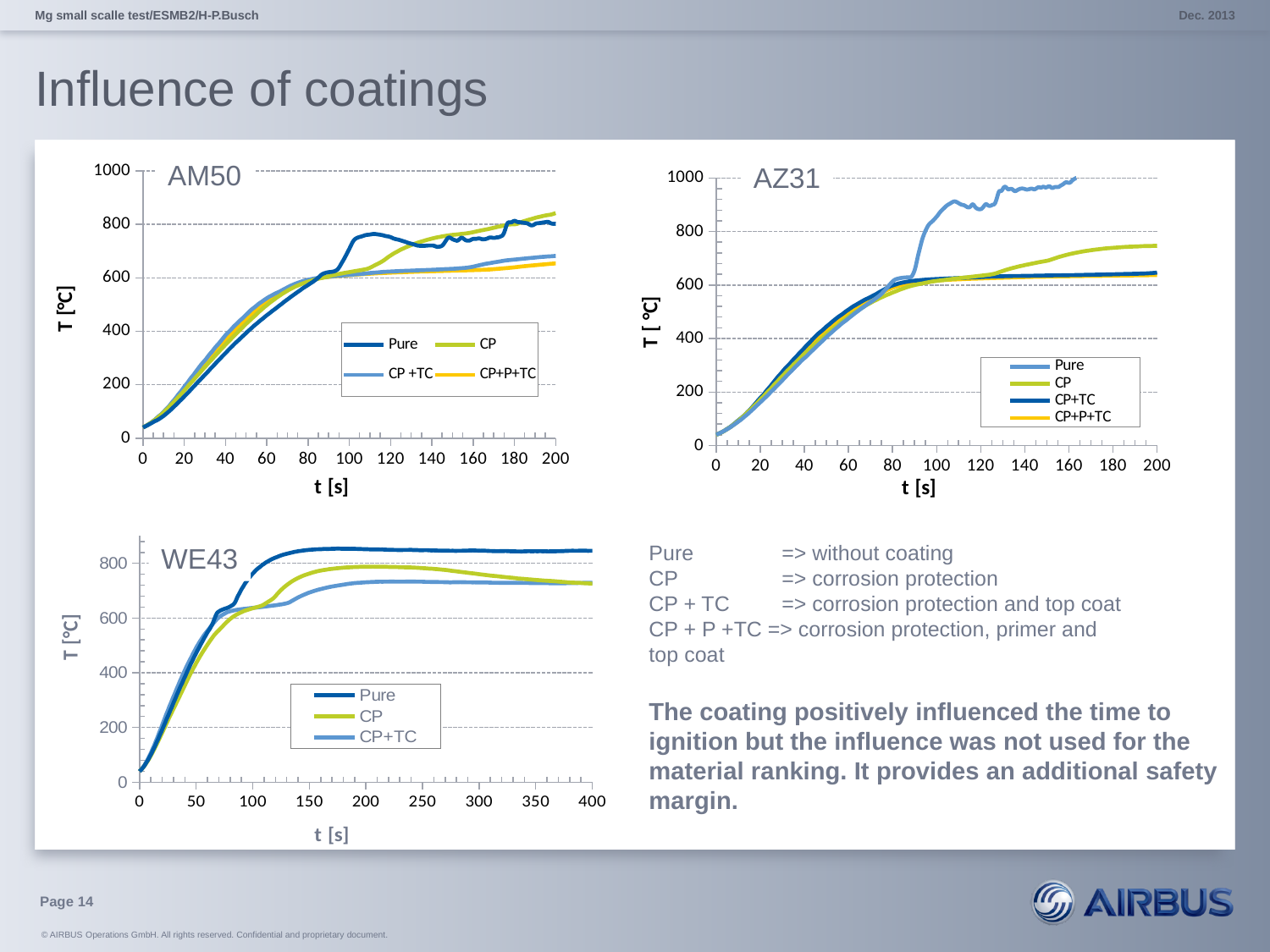
How many series does the legend of the AM50 chart list? 4 In the WE43 chart, which series has the highest temperature at t = 400 s? Pure In the AZ31 chart, which series reaches the highest temperature? Pure In the AM50 chart, is the value for CP at t = 200 s greater or less than 800? greater In the WE43 chart, does the temperature for CP rise or fall between t = 0 s and t = 150 s? rise In the AM50 chart, at t = 200 s, which is larger: CP or CP+P+TC? CP What is the label of the x axis on the AZ31 chart? t [s] In the WE43 chart, is the value for Pure at t = 400 s greater or less than 800? greater In the AM50 chart, is the value for CP+P+TC at t = 200 s greater or less than 800? less What type of chart is the AM50 chart? line chart How many series does the legend of the WE43 chart list? 3